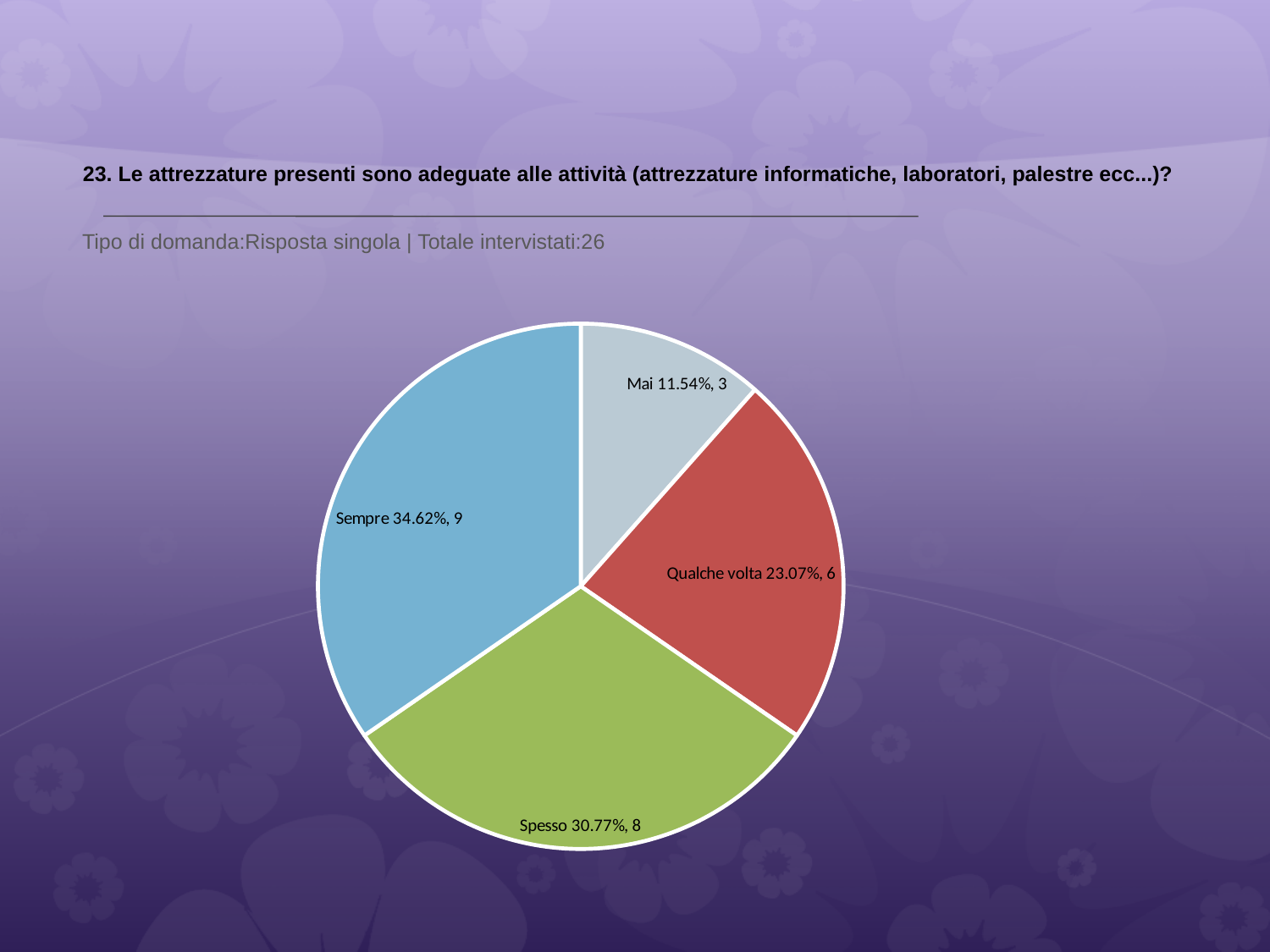
What is the difference in respondent count between 'Sempre' and 'Mai'? 6 How many respondents chose 'Mai'? 3 What colour is the 'Spesso' slice? green How many slices does the pie chart have? 4 Which category has the largest share of the pie? Sempre What kind of chart is shown on the slide? pie chart What percentage is shown for 'Qualche volta'? 23.07% What is the total number of respondents stated on the slide? 26 How many respondents chose 'Spesso'? 8 Which has more respondents, 'Spesso' or 'Qualche volta'? Spesso Which category has the smallest share of the pie? Mai What percentage is shown for the 'Sempre' slice? 34.62%